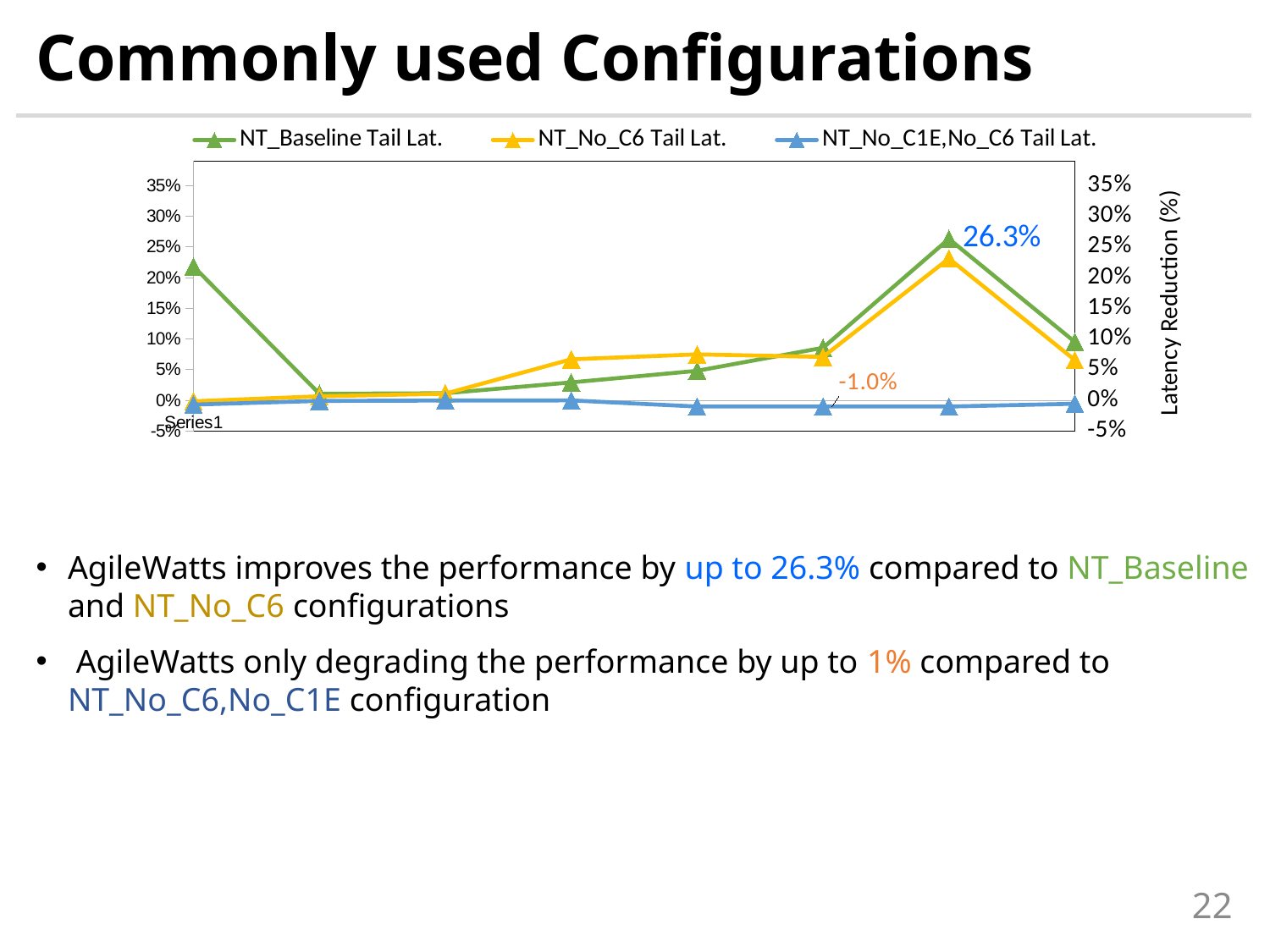
Is the peak value of the NT_No_C6 Tail Lat. line greater or less than 20%? greater Does the NT_Baseline Tail Lat. line rise or fall from its first point to its second point? fall How many data points are plotted on each line in the chart? 8 Which series stays lowest across the chart? NT_No_C1E,No_C6 Tail Lat. What kind of chart is shown on the slide? line chart What are the three series named in the chart legend? NT_Baseline Tail Lat., NT_No_C6 Tail Lat., NT_No_C1E,No_C6 Tail Lat. What is the peak value labeled on the NT_Baseline Tail Lat. line? 26.3% What is the title of the right-hand vertical axis of the chart? Latency Reduction (%) How many series does the chart legend list? 3 At the peak (seventh point), which line is higher: NT_Baseline Tail Lat. or NT_No_C6 Tail Lat.? NT_Baseline Tail Lat. What value is labeled on the NT_No_C1E,No_C6 Tail Lat. line? -1.0% Which series reaches the highest value in the chart? NT_Baseline Tail Lat.